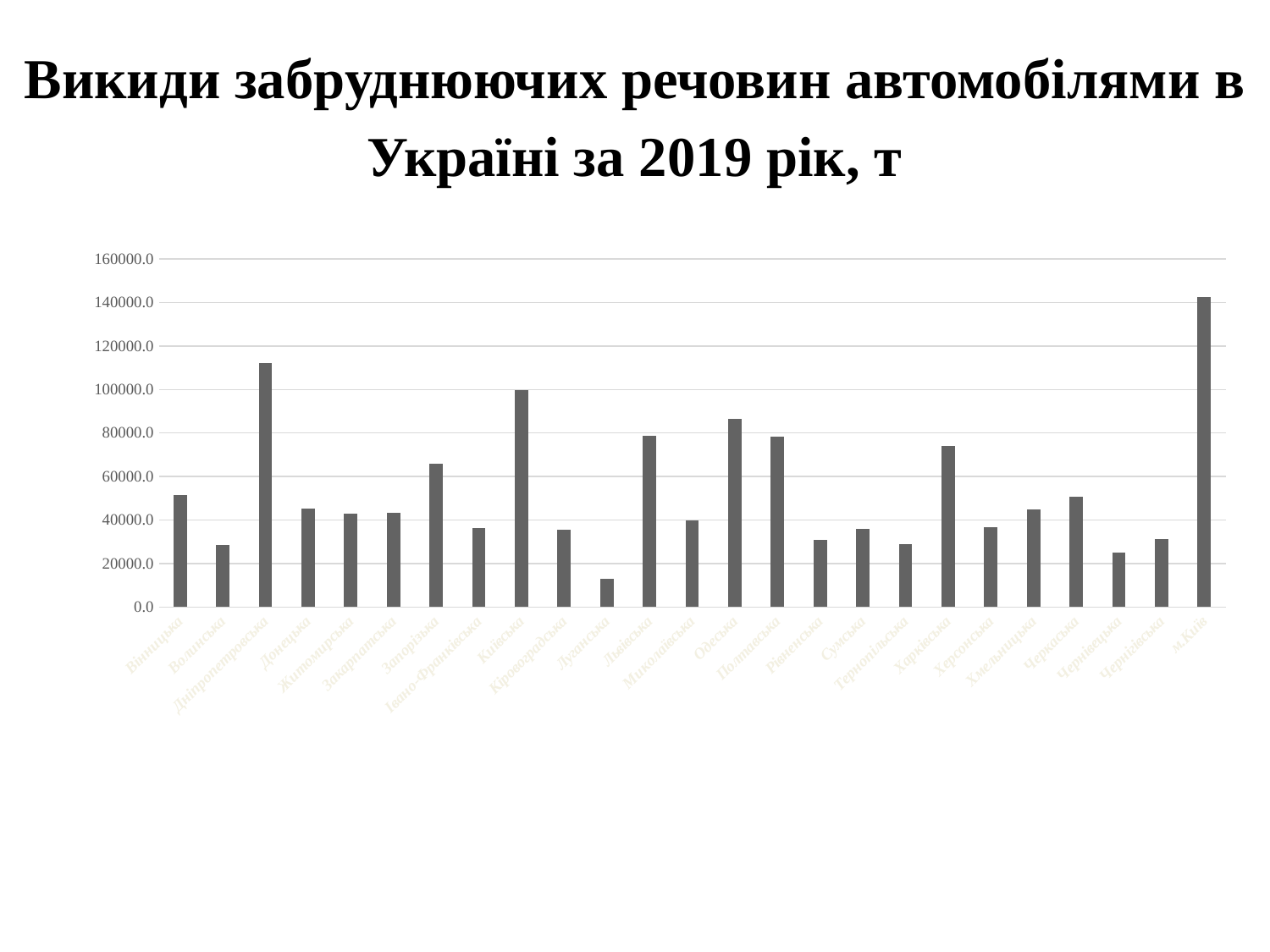
Which category has the lowest value in the chart? Луганська How many categories (regions) are plotted on the x axis? 25 Which is larger, the value for Дніпропетровська or the value for Одеська? Дніпропетровська Which category has the highest value in the chart? м.Київ What kind of chart is shown on the slide? bar chart Is the value for Дніпропетровська greater or less than 100000? greater What is the title of the slide? Викиди забруднюючих речовин автомобілями в Україні за 2019 рік, т Is the value for Одеська greater or less than 80000? greater Is the value for Луганська greater or less than 20000? less Which is larger, the value for Волинська or the value for Черкаська? Черкаська